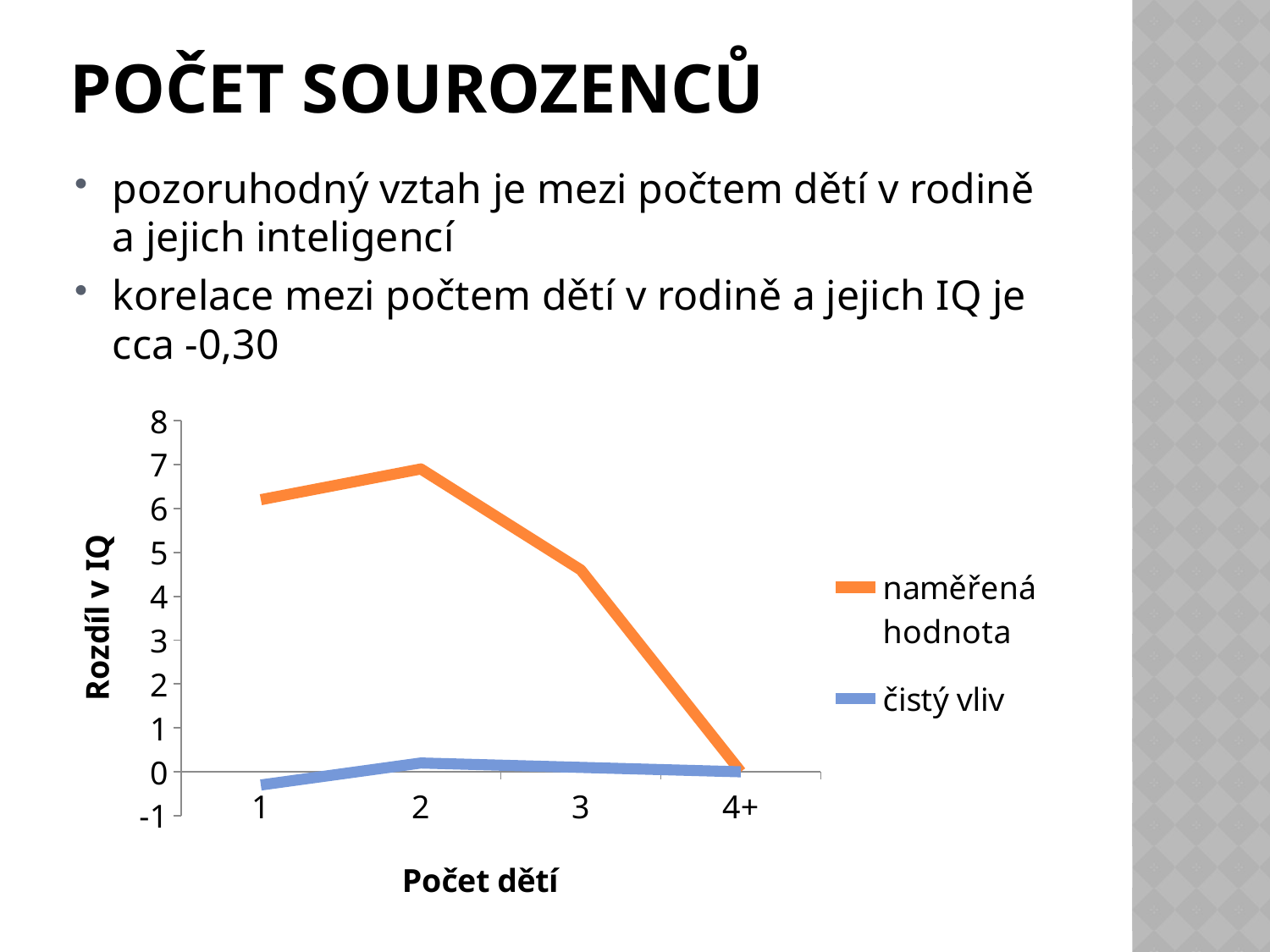
Is the 'naměřená hodnota' value for 3 children greater or less than 5? less How many series does the chart legend list? 2 Is the 'naměřená hodnota' value for 1 child greater or less than 5? greater What is the title of the y axis of the chart? Rozdíl v IQ What kind of chart is shown on the slide? line chart Does the 'naměřená hodnota' line rise or fall from 2 children to 4+ children? fall Which series is drawn in orange in the chart? naměřená hodnota For which number of children is the 'naměřená hodnota' line lowest? 4+ How many categories are shown on the x axis of the chart? 4 For which number of children is the 'naměřená hodnota' line highest? 2 Is the 'naměřená hodnota' value for 2 children greater or less than 6? greater Which series has the larger value for 2 children, 'naměřená hodnota' or 'čistý vliv'? naměřená hodnota